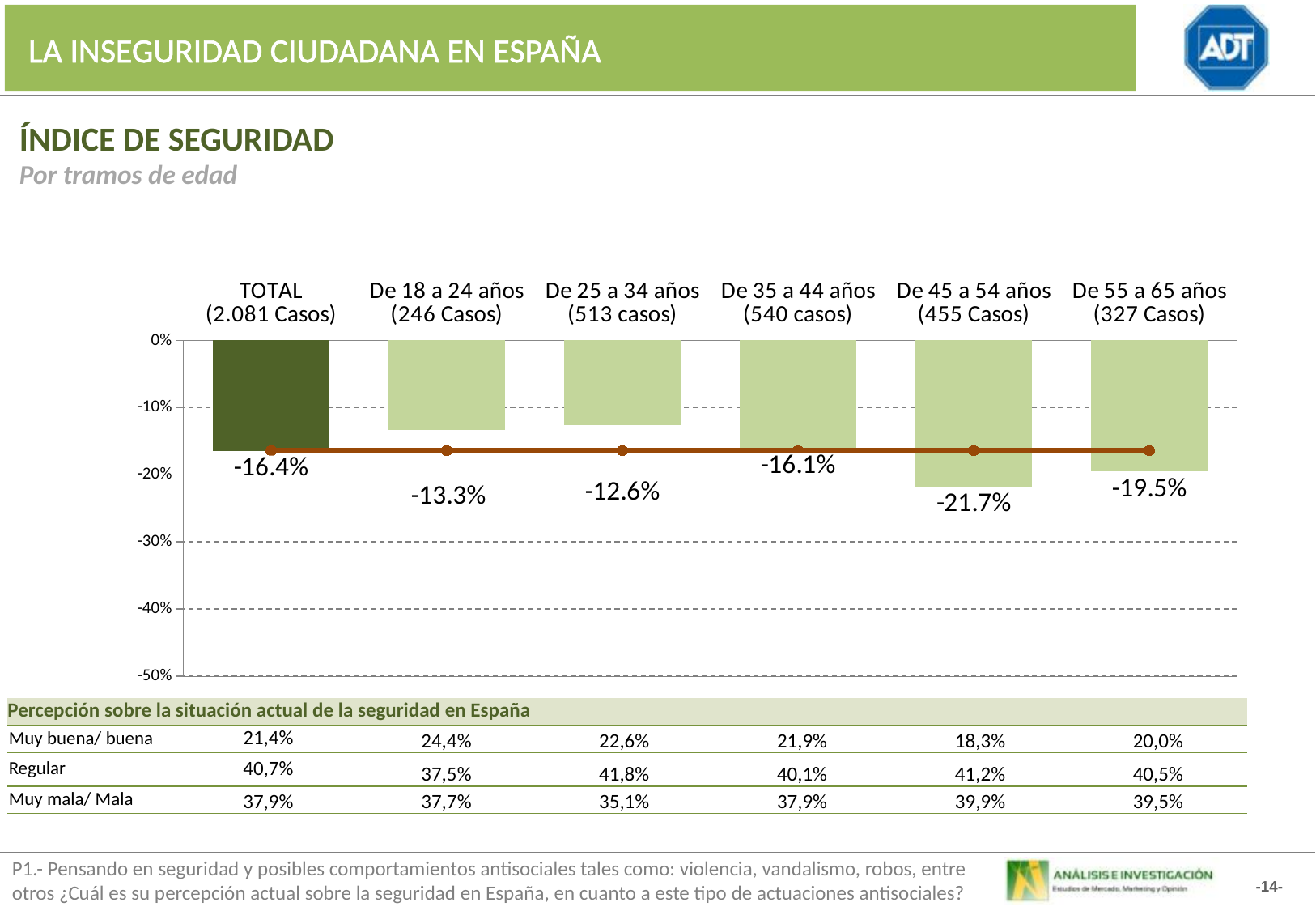
How many cases does the TOTAL category label indicate? 2.081 Casos Which has the larger (less negative) value: 'De 35 a 44 años' or 'De 55 a 65 años'? De 35 a 44 años What is the difference in percentage points between the values for 'De 45 a 54 años' (-21.7%) and 'De 55 a 65 años' (-19.5%)? 2.2 percentage points What is the value of the security index for the TOTAL group? -16.4% What is the security index value for the 'De 45 a 54 años' age group? -21.7% What is the security index value for the 'De 55 a 65 años' age group? -19.5% Which age group has the highest (least negative) security index value? De 25 a 34 años What kind of chart is used to show the security index by age group? Bar chart Which age group has the lowest (most negative) security index value? De 45 a 54 años Is the value for 'De 45 a 54 años' greater or less than -20%? less How many categories (bars) are shown in the chart? 6 What is the security index value for the 'De 25 a 34 años' age group? -12.6%